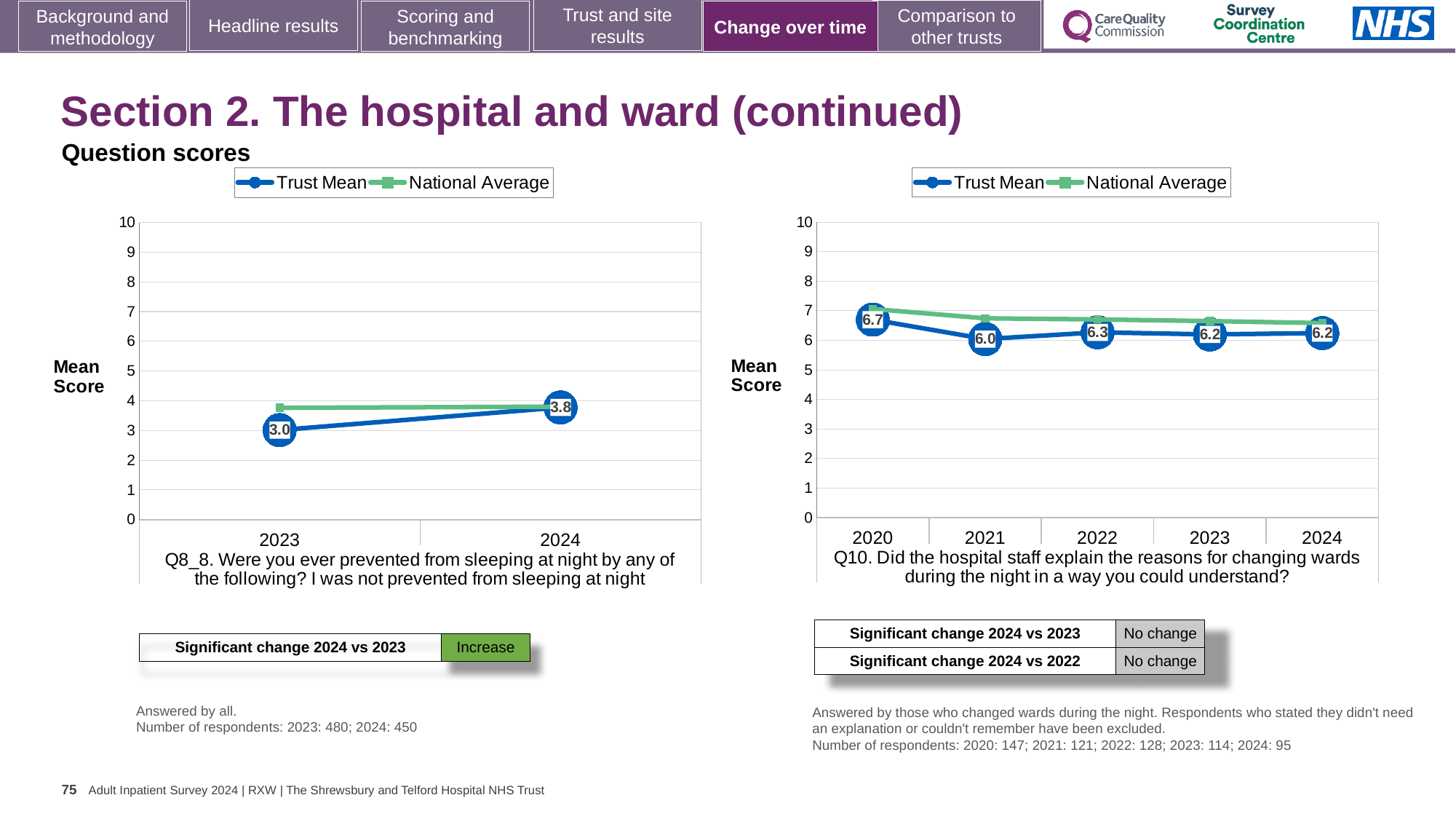
On the right chart (Q10), what is the Trust Mean score for 2021? 6.0 On the left chart (Q8_8), what is the Trust Mean score for 2023? 3.0 On the right chart (Q10), what is the Trust Mean score for 2020? 6.7 On the left chart (Q8_8), by how much did the Trust Mean change from 2023 to 2024? 0.8 On the left chart (Q8_8), what is the Trust Mean score for 2024? 3.8 On the right chart (Q10), what is the difference between the Trust Mean scores for 2020 and 2021? 0.7 On the right chart (Q10), how many years are plotted on the x axis? 5 On the right chart (Q10), which year has the highest Trust Mean score? 2020 On the right chart (Q10), which year has the lowest Trust Mean score? 2021 On the left chart (Q8_8), does the Trust Mean rise or fall from 2023 to 2024? rise What type of chart is used on the right (Q10)? line chart On the left chart (Q8_8), is the National Average value for 2023 greater or less than 3? greater